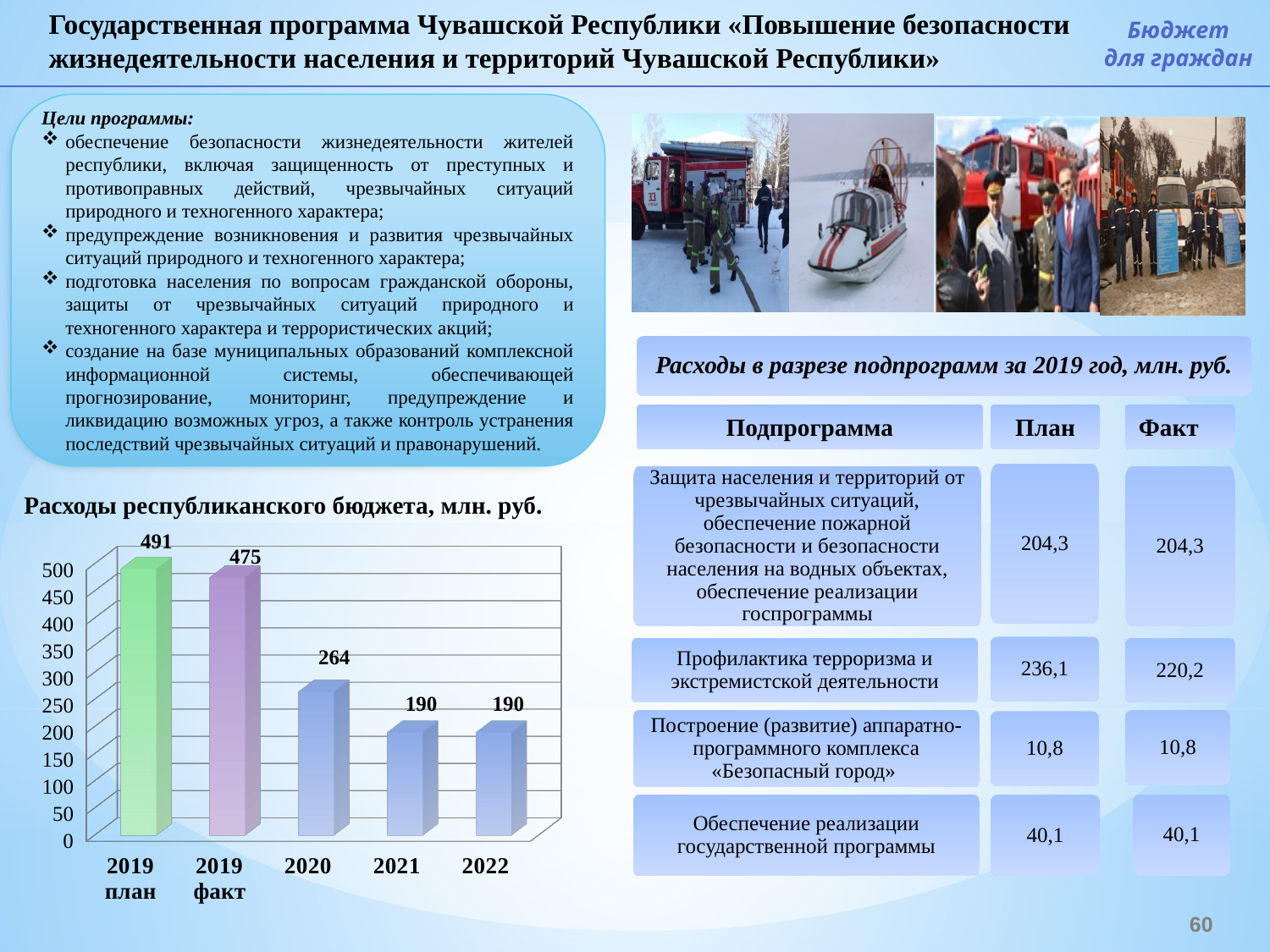
What is the difference between the '2019 план' and '2019 факт' values in the chart 'Расходы республиканского бюджета, млн. руб.'? 16 What is the value for '2019 план' in the chart 'Расходы республиканского бюджета, млн. руб.'? 491 Do the values in the chart 'Расходы республиканского бюджета, млн. руб.' generally rise or fall from left to right? fall What is the value for '2019 факт' in the chart 'Расходы республиканского бюджета, млн. руб.'? 475 What type of chart is used to show 'Расходы республиканского бюджета, млн. руб.'? bar chart Which category has the highest value in the chart 'Расходы республиканского бюджета, млн. руб.'? 2019 план Is the value for 2020 in the chart 'Расходы республиканского бюджета, млн. руб.' greater or less than 300? less What is the value for 2022 in the chart 'Расходы республиканского бюджета, млн. руб.'? 190 What is the difference between the 2020 and 2021 values in the chart 'Расходы республиканского бюджета, млн. руб.'? 74 How many bars are shown in the chart 'Расходы республиканского бюджета, млн. руб.'? 5 Which is larger in the chart 'Расходы республиканского бюджета, млн. руб.': the value for '2019 факт' or the value for 2020? 2019 факт What is the value for 2020 in the chart 'Расходы республиканского бюджета, млн. руб.'? 264